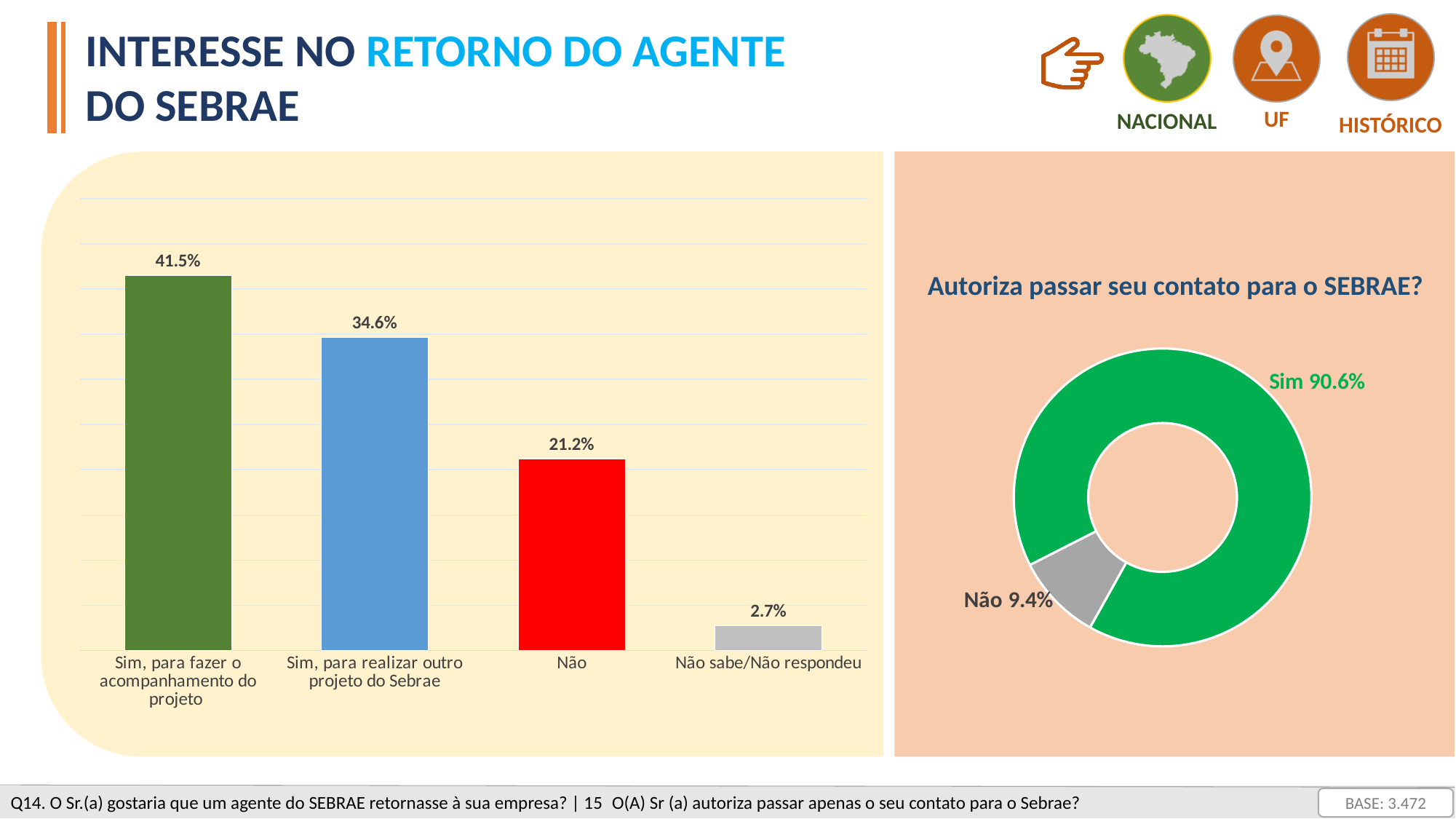
In the bar chart on the left, what is the value for 'Sim, para fazer o acompanhamento do projeto'? 41.5% What kind of chart is on the left side of the slide? Bar chart In the chart titled 'Autoriza passar seu contato para o SEBRAE?', what is the value for 'Sim'? 90.6% In the bar chart on the left, which category has the highest value? Sim, para fazer o acompanhamento do projeto In the bar chart on the left, what is the value for 'Não sabe/Não respondeu'? 2.7% In the chart titled 'Autoriza passar seu contato para o SEBRAE?', what is the value for 'Não'? 9.4% In the bar chart on the left, what is the difference between 'Sim, para fazer o acompanhamento do projeto' and 'Sim, para realizar outro projeto do Sebrae'? 6.9% What kind of chart is titled 'Autoriza passar seu contato para o SEBRAE?'? Doughnut chart In the bar chart on the left, which category has the lowest value? Não sabe/Não respondeu In the bar chart on the left, which is larger: 'Sim, para realizar outro projeto do Sebrae' or 'Não'? Sim, para realizar outro projeto do Sebrae In the bar chart on the left, what is the value for 'Não'? 21.2% How many categories are shown in the bar chart on the left? 4